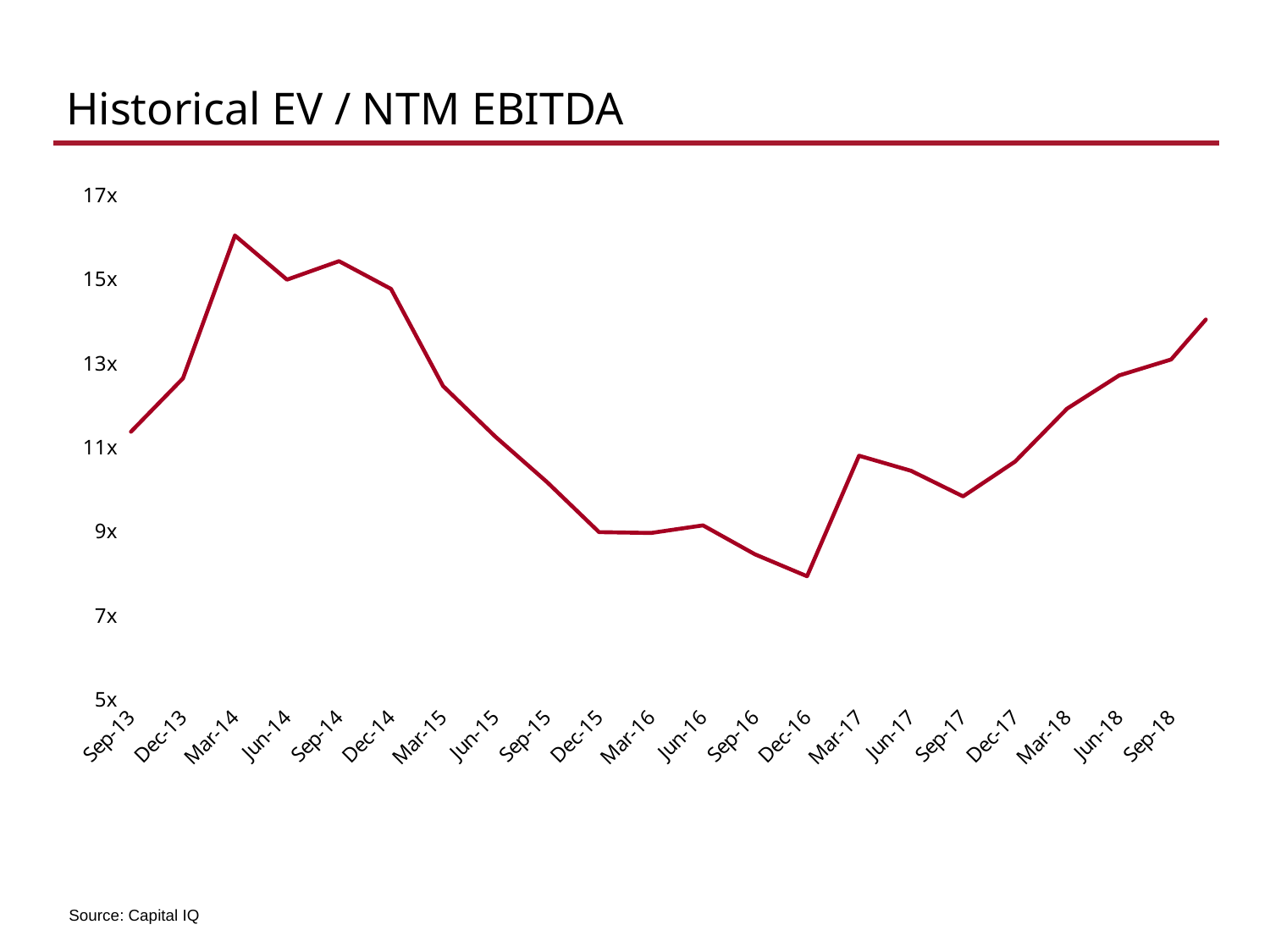
What kind of chart is shown on the slide? Line chart Is the value for Dec-16 greater or less than 9x? less What is the title of the chart? Historical EV / NTM EBITDA Does the multiple rise or fall between Mar-14 and Dec-16? Fall Which is larger, the value for Sep-18 or the value for Sep-13? Sep-18 Is the value for Mar-14 greater or less than 15x? greater At which date does the EV / NTM EBITDA multiple reach its highest point? Mar-14 What source is cited for the chart data? Capital IQ At which date does the EV / NTM EBITDA multiple reach its lowest point? Dec-16 Is the value for Sep-17 greater or less than 11x? less